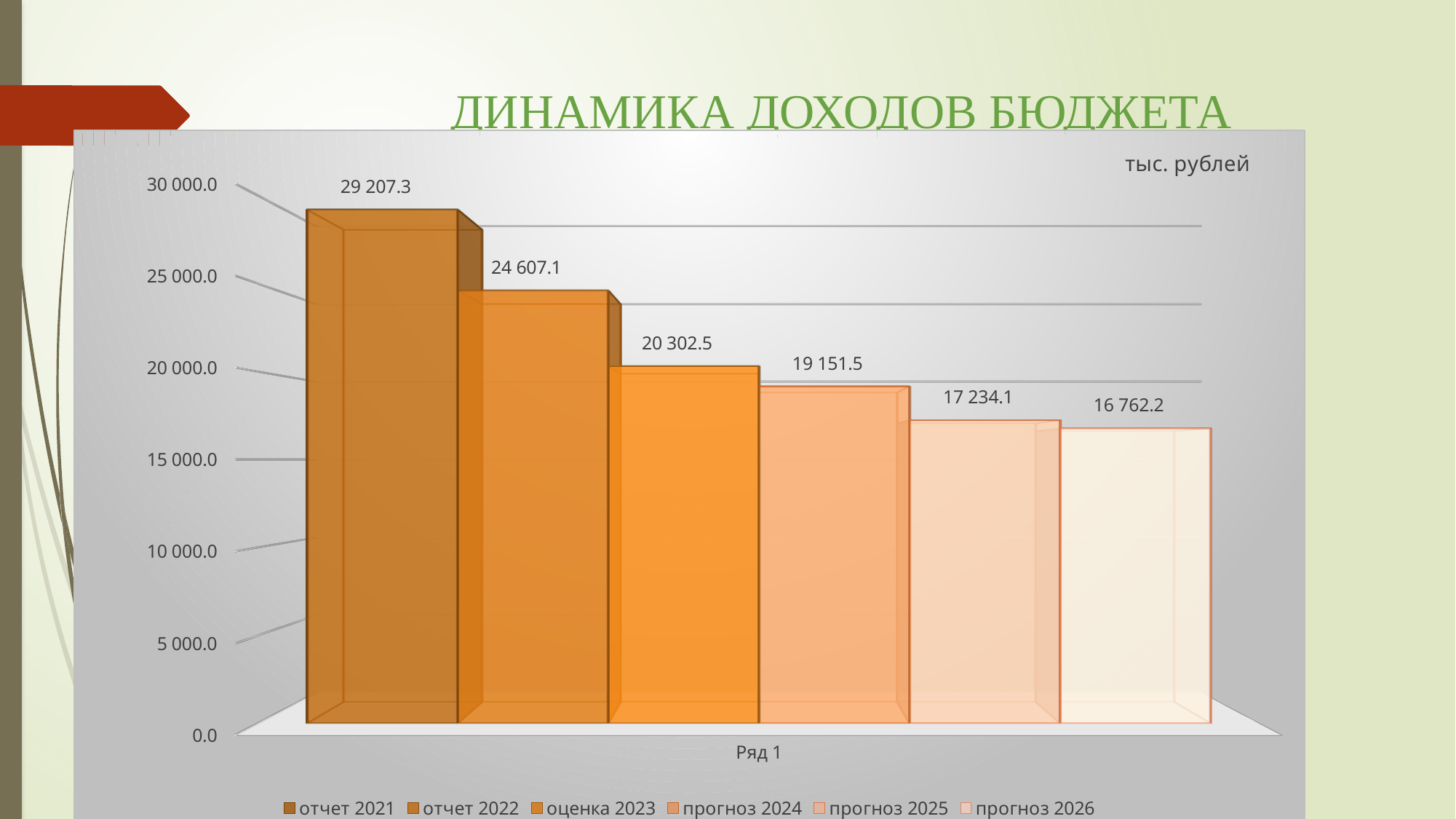
Is the value for отчет 2022 greater or less than 25 000.0? less Do the values rise or fall from отчет 2021 to прогноз 2026? fall What kind of chart is shown on the slide? bar chart Which series has the highest value? отчет 2021 What is the difference between the values for прогноз 2025 and прогноз 2026? 471.9 How many series does the legend list? 6 Which is larger, the value for оценка 2023 or the value for прогноз 2024? оценка 2023 What is the value for прогноз 2026? 16 762.2 What is the difference between the values for отчет 2021 and отчет 2022? 4 600.2 What is the value for отчет 2021? 29 207.3 What is the value for прогноз 2024? 19 151.5 Which series has the lowest value? прогноз 2026